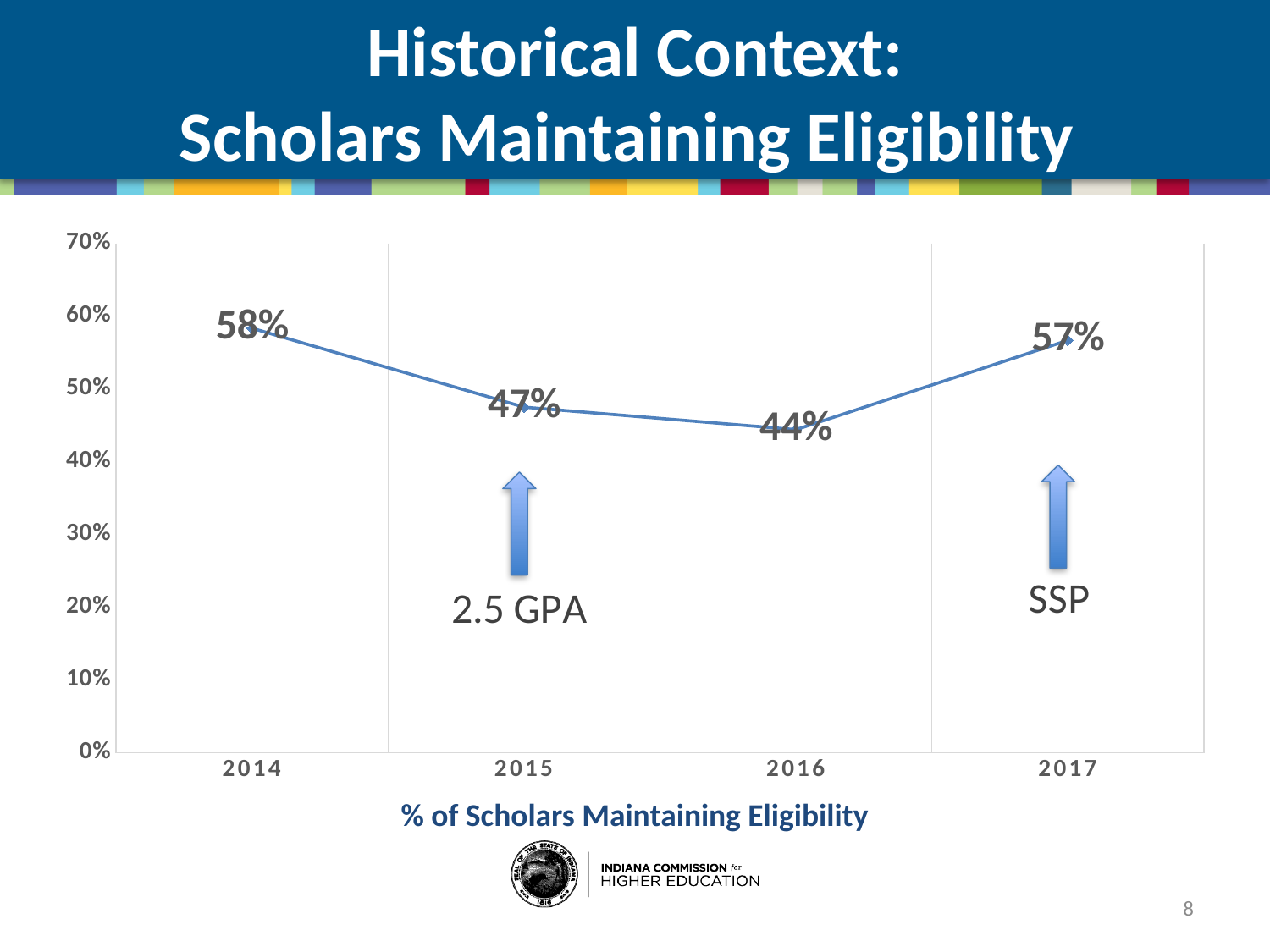
How many years are plotted on the chart? 4 Which year has the lowest percentage of scholars maintaining eligibility? 2016 What percentage of scholars maintained eligibility in 2014? 58% What is the difference in percentage points between 2014 and 2016? 14 Which year has the highest percentage of scholars maintaining eligibility? 2014 What is the series label shown below the chart? % of Scholars Maintaining Eligibility What is the value for 2017? 57% Which year has a higher value, 2015 or 2017? 2017 What percentage of scholars maintained eligibility in 2016? 44% Is the value for 2015 greater or less than 50%? less What kind of chart is shown on the slide? line chart What is the difference in percentage points between 2017 and 2016? 13